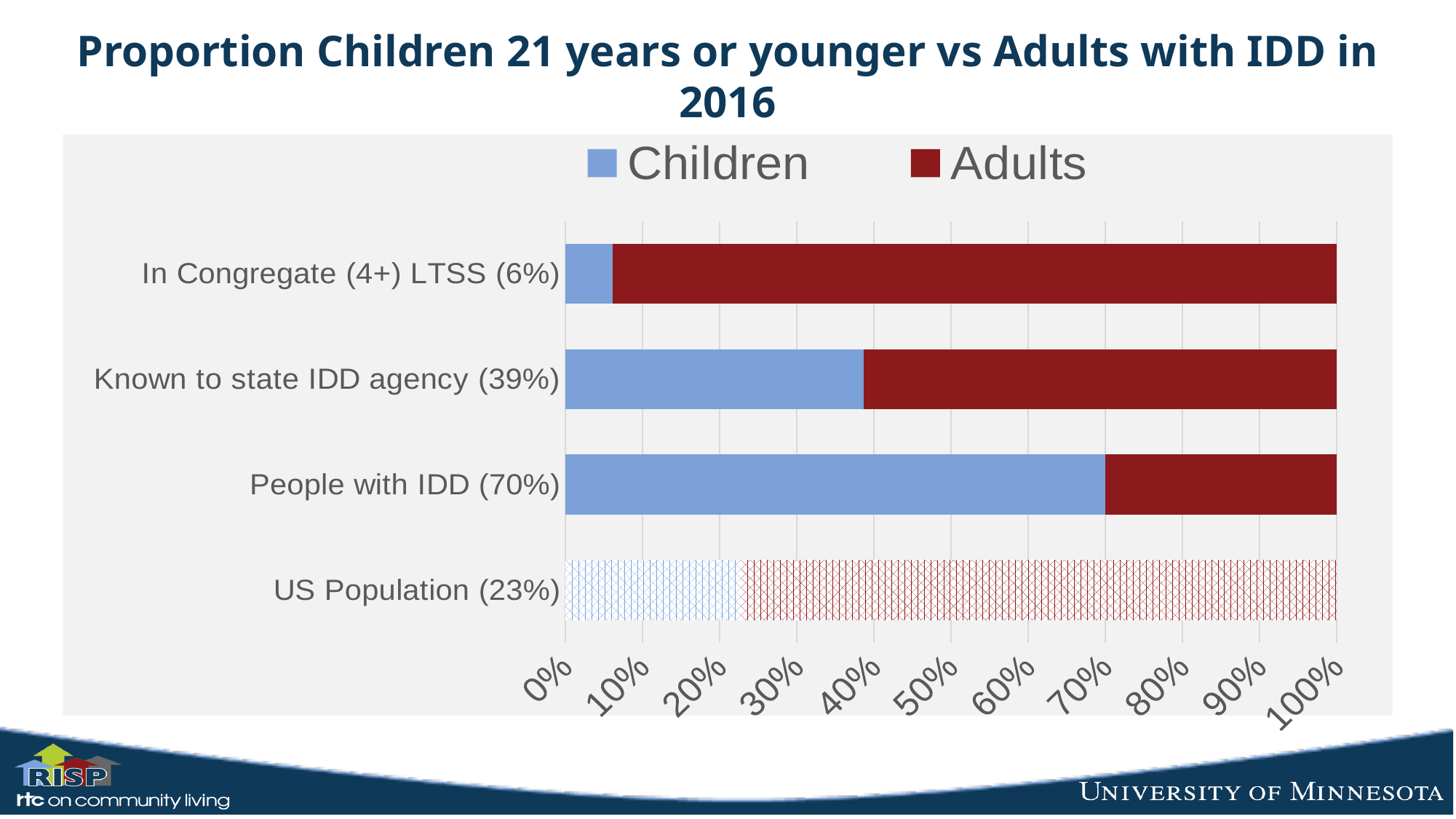
How many series does the legend list? 2 What proportion of children is shown for the 'US Population' category? 23% What kind of chart is shown on the slide? Stacked bar chart Is the Adults share for 'In Congregate (4+) LTSS' greater or less than 90%? greater Which category has the lowest proportion of children? In Congregate (4+) LTSS (6%) Which category has the highest proportion of children? People with IDD (70%) Which series is shown in dark red in the legend? Adults What proportion of children is shown for the 'Known to state IDD agency' category? 39% What proportion of children is shown for the 'People with IDD' category? 70% What proportion of children is shown for the 'In Congregate (4+) LTSS' category? 6% What is the difference in the children proportion between 'People with IDD' and 'Known to state IDD agency'? 31 percentage points How many categories are plotted on the chart? 4